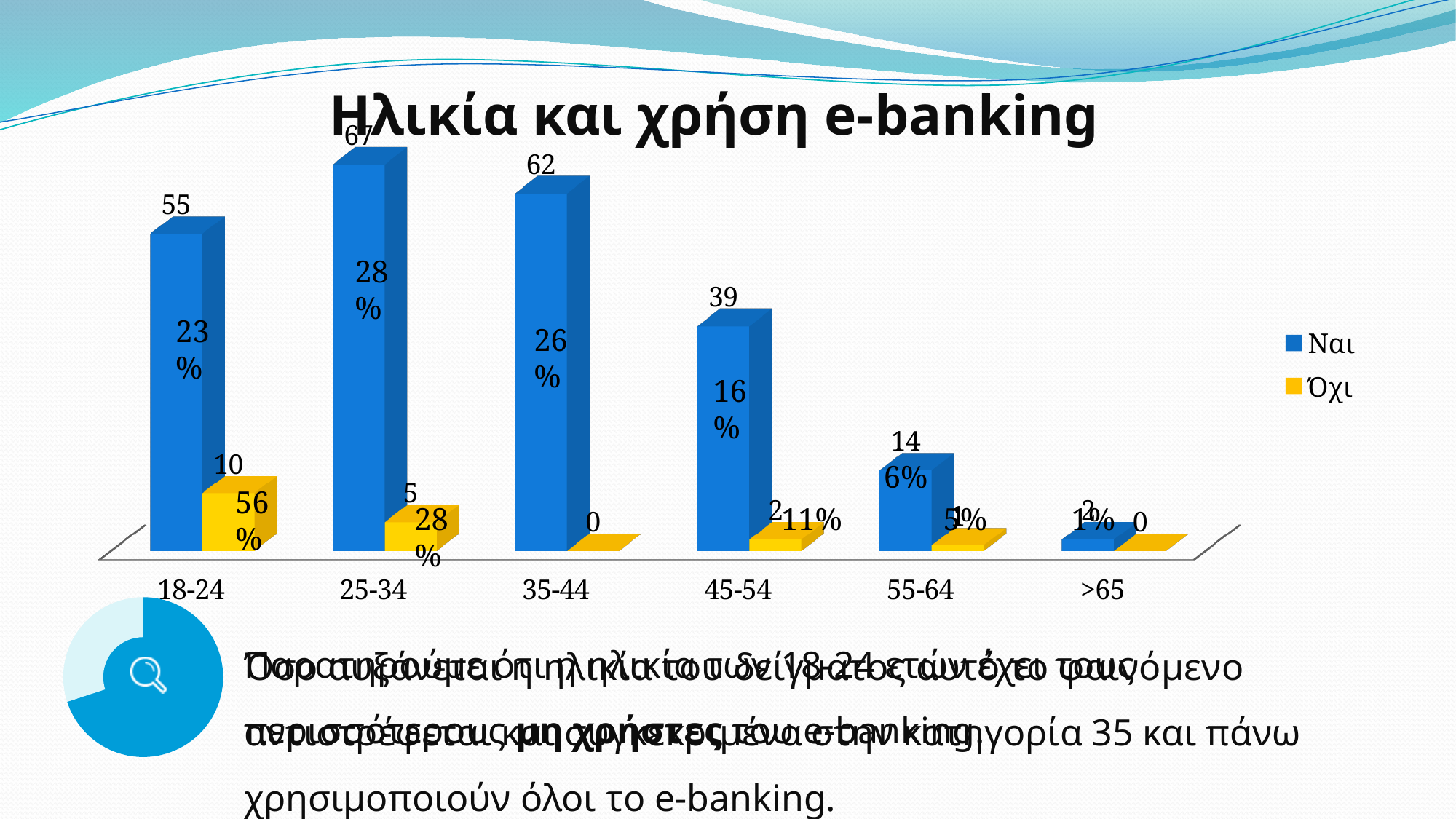
What type of chart is shown on the slide? bar chart What is the value of the Όχι series for the 18-24 age group? 10 What is the value of the Ναι series for the 25-34 age group? 67 How many series does the legend list? 2 Which age group has the highest Ναι value? 25-34 What is the total of the Ναι and Όχι values for the 55-64 age group? 15 What is the title of the chart? Ηλικία και χρήση e-banking Which age group has the highest Όχι value? 18-24 Which is larger: the Ναι value for 18-24 or the Ναι value for 45-54? 18-24 How many age categories are shown on the x axis? 6 What is the value of the Ναι series for the 45-54 age group? 39 What is the difference between the Ναι values for 25-34 and 35-44? 5